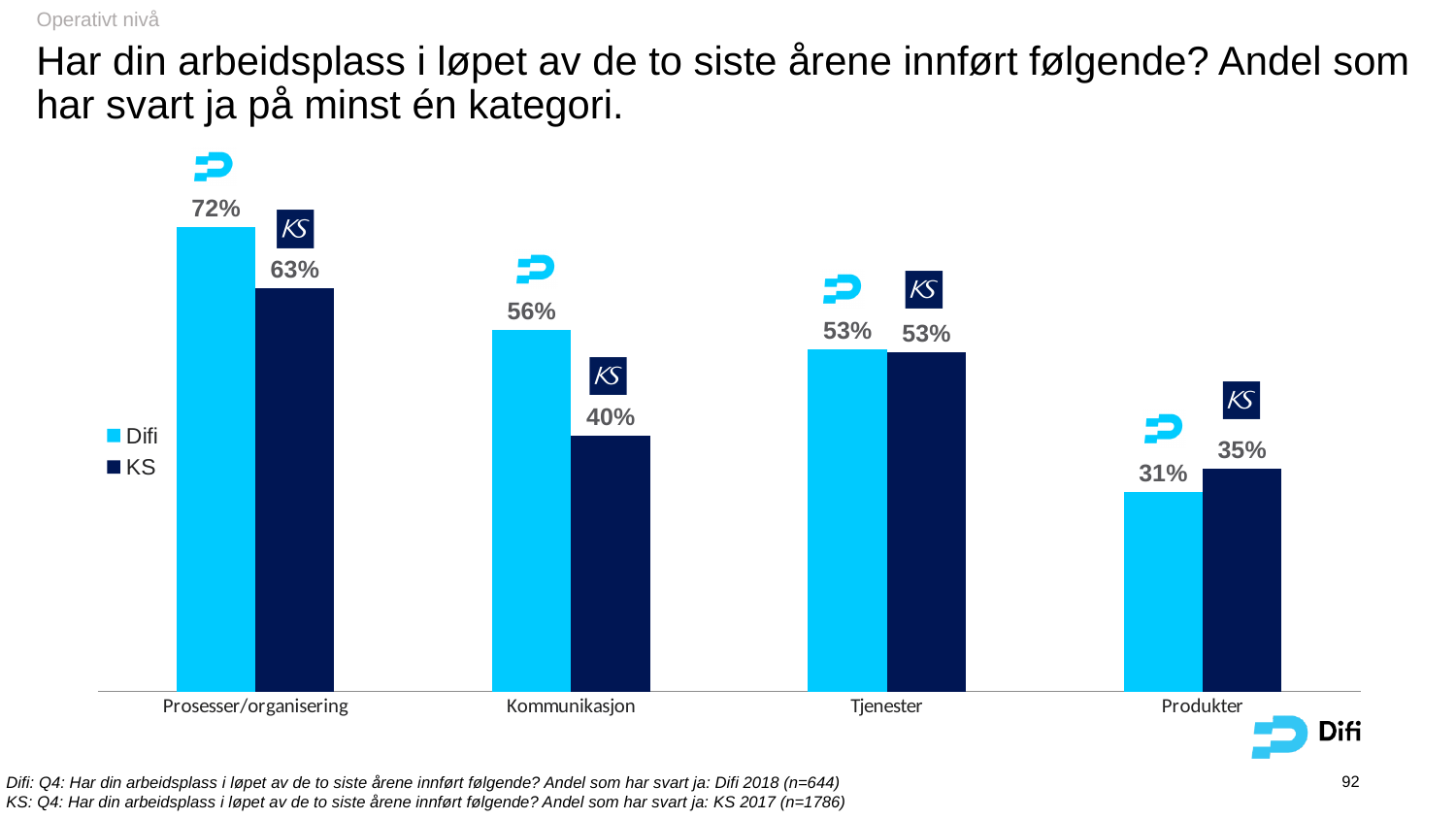
What kind of chart is shown on the slide? Bar chart What is the difference between the Difi values for Prosesser/organisering and Produkter? 41% What is the KS value for Kommunikasjon? 40% What is the KS value for Produkter? 35% Which series is shown in dark navy blue? KS How many series does the legend list? 2 How many categories are shown on the x axis? 4 Which category has the lowest KS value? Produkter What is the difference between the Difi and KS values for Kommunikasjon? 16% For Produkter, which series has the larger value, Difi or KS? KS What is the Difi value for Prosesser/organisering? 72% Which category has the highest Difi value? Prosesser/organisering